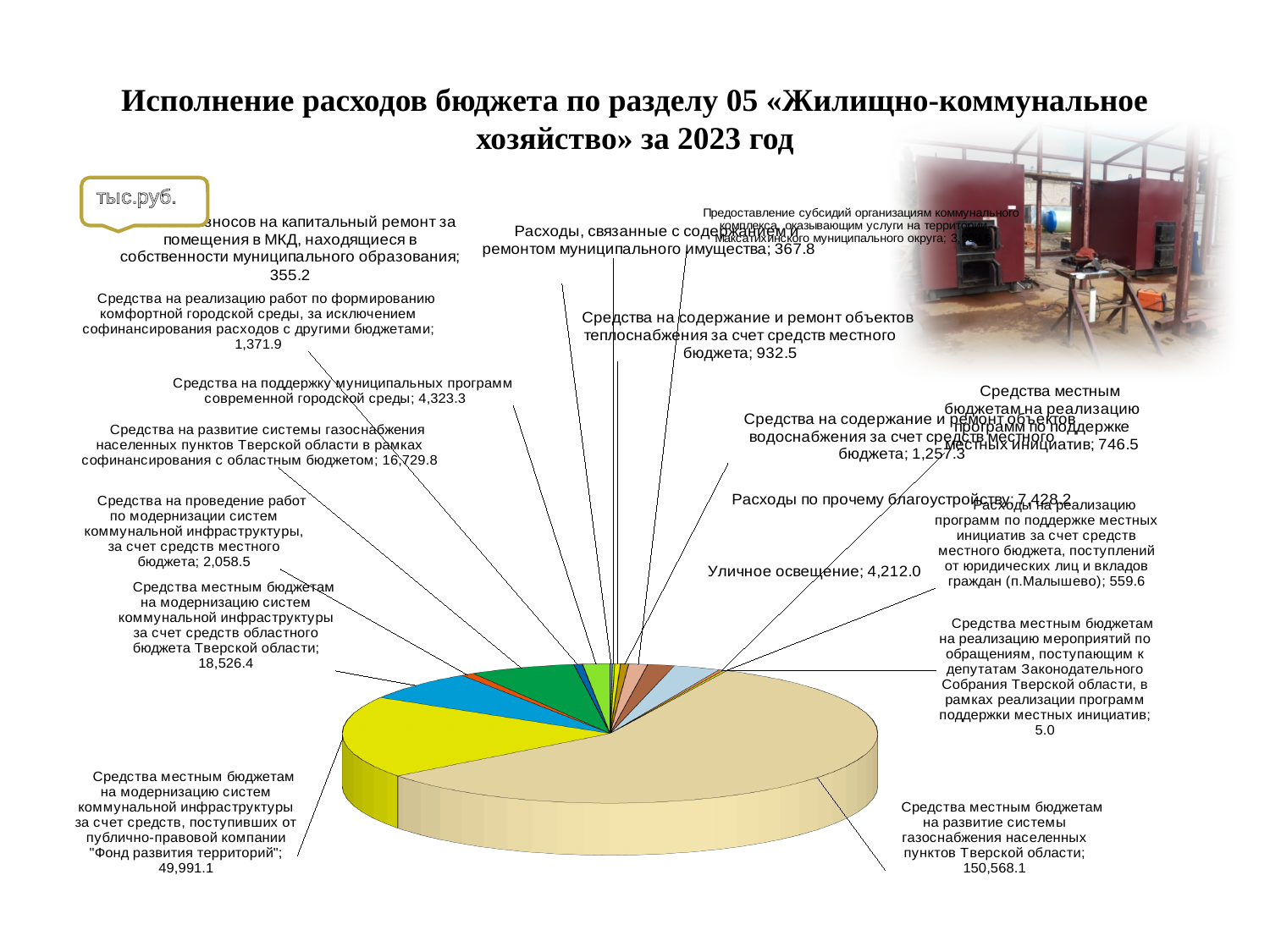
Which category has the smallest value on the chart? Средства местным бюджетам на реализацию мероприятий по обращениям, поступающим к депутатам Законодательного Собрания Тверской области, в рамках реализации программ поддержки местных инициатив What kind of chart is shown on the slide? pie chart What is the value for "Средства местным бюджетам на развитие системы газоснабжения населенных пунктов Тверской области"? 150,568.1 Which category has the largest slice of the pie? Средства местным бюджетам на развитие системы газоснабжения населенных пунктов Тверской области What is the difference between "Расходы по прочему благоустройству" (7,428.2) and "Уличное освещение" (4,212.0)? 3,216.2 What is the value for "Средства местным бюджетам на модернизацию систем коммунальной инфраструктуры за счет средств, поступивших от публично-правовой компании "Фонд развития территорий""? 49,991.1 What is the value for "Средства на содержание и ремонт объектов теплоснабжения за счет средств местного бюджета"? 932.5 What is the title of the slide? Исполнение расходов бюджета по разделу 05 «Жилищно-коммунальное хозяйство» за 2023 год What is the value for "Расходы по прочему благоустройству"? 7,428.2 In what units are the chart values given, according to the callout on the slide? тыс.руб. What is the value for "Уличное освещение"? 4,212.0 Which is larger: "Средства местным бюджетам на модернизацию систем коммунальной инфраструктуры за счет средств областного бюджета Тверской области" or "Средства на развитие системы газоснабжения населенных пунктов Тверской области в рамках софинансирования с областным бюджетом"? Средства местным бюджетам на модернизацию систем коммунальной инфраструктуры за счет средств областного бюджета Тверской области